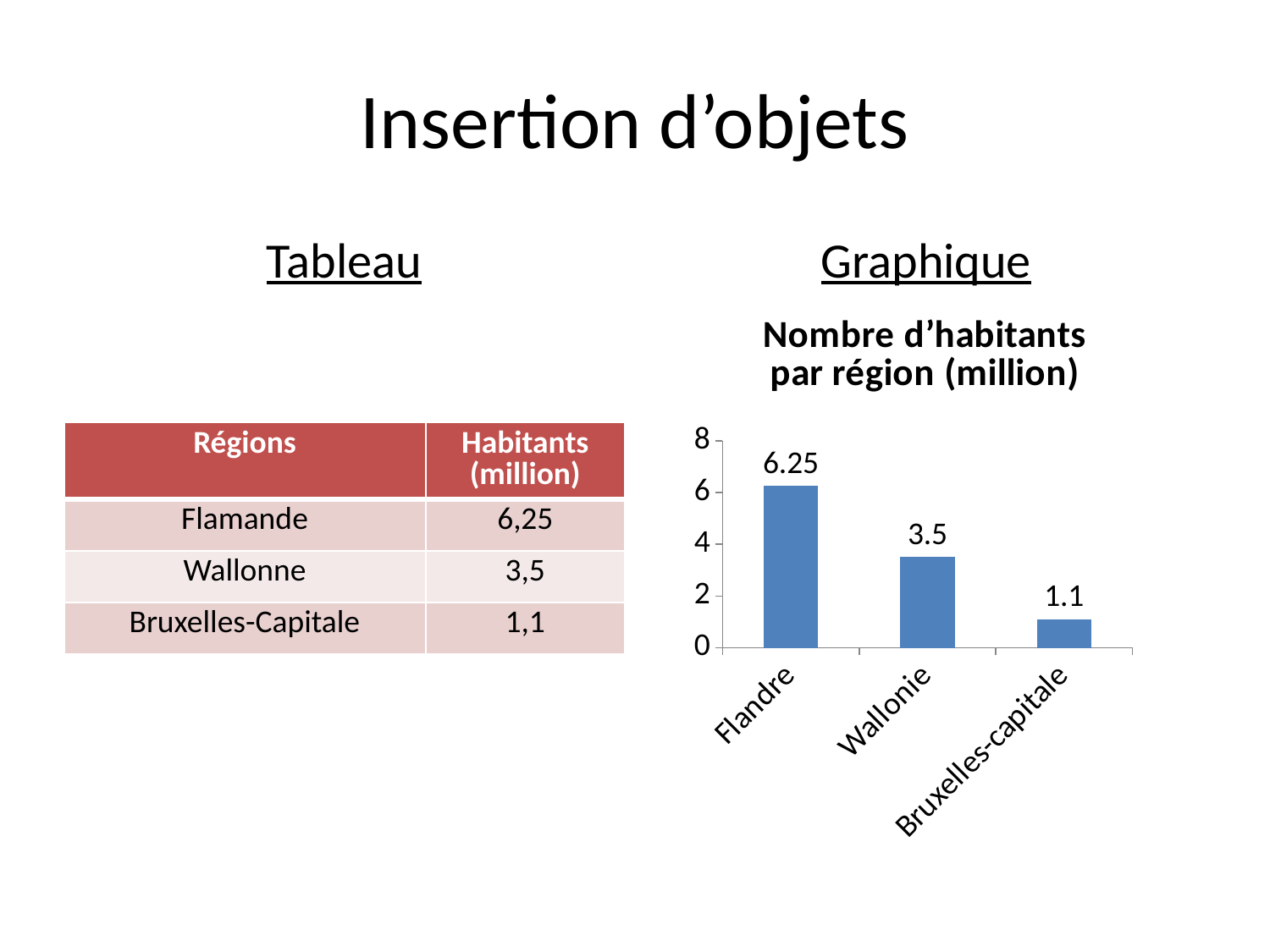
Which region has the highest value in the chart? Flandre What is the title of the chart? Nombre d’habitants par région (million) Is the value for Flandre greater or less than 4? greater What is the difference between the values for Wallonie and Bruxelles-capitale? 2.4 What is the value for Flandre in the chart? 6.25 How many regions are shown in the chart? 3 What is the value for Bruxelles-capitale in the chart? 1.1 What is the difference between the values for Flandre and Wallonie? 2.75 What is the value for Wallonie in the chart? 3.5 Which region has the lowest value in the chart? Bruxelles-capitale What kind of chart is shown on the slide? Bar chart Which is larger, the value for Wallonie or the value for Bruxelles-capitale? Wallonie